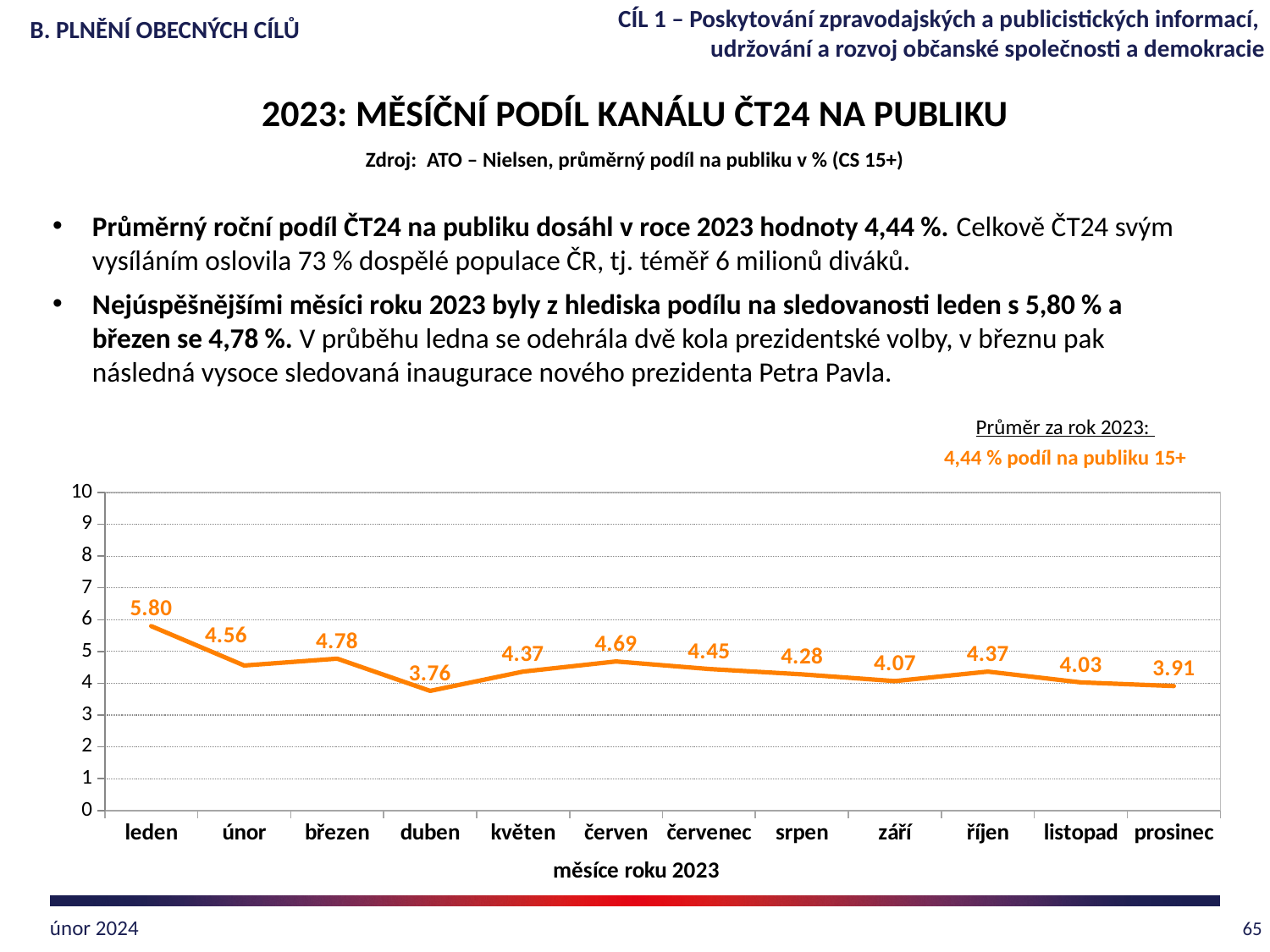
What is the x-axis title of the chart? měsíce roku 2023 Which is larger, the value for březen or the value for červenec? březen What is the value for červen? 4.69 Which month has the lowest value? duben What kind of chart is shown on the slide? line chart Is the value for leden greater or less than 5? greater Which month has the highest value? leden What is the value for duben? 3.76 What is the value for prosinec? 3.91 What is the value for leden? 5.80 How many months are plotted on the x axis? 12 What is the difference between the values for leden and únor? 1.24